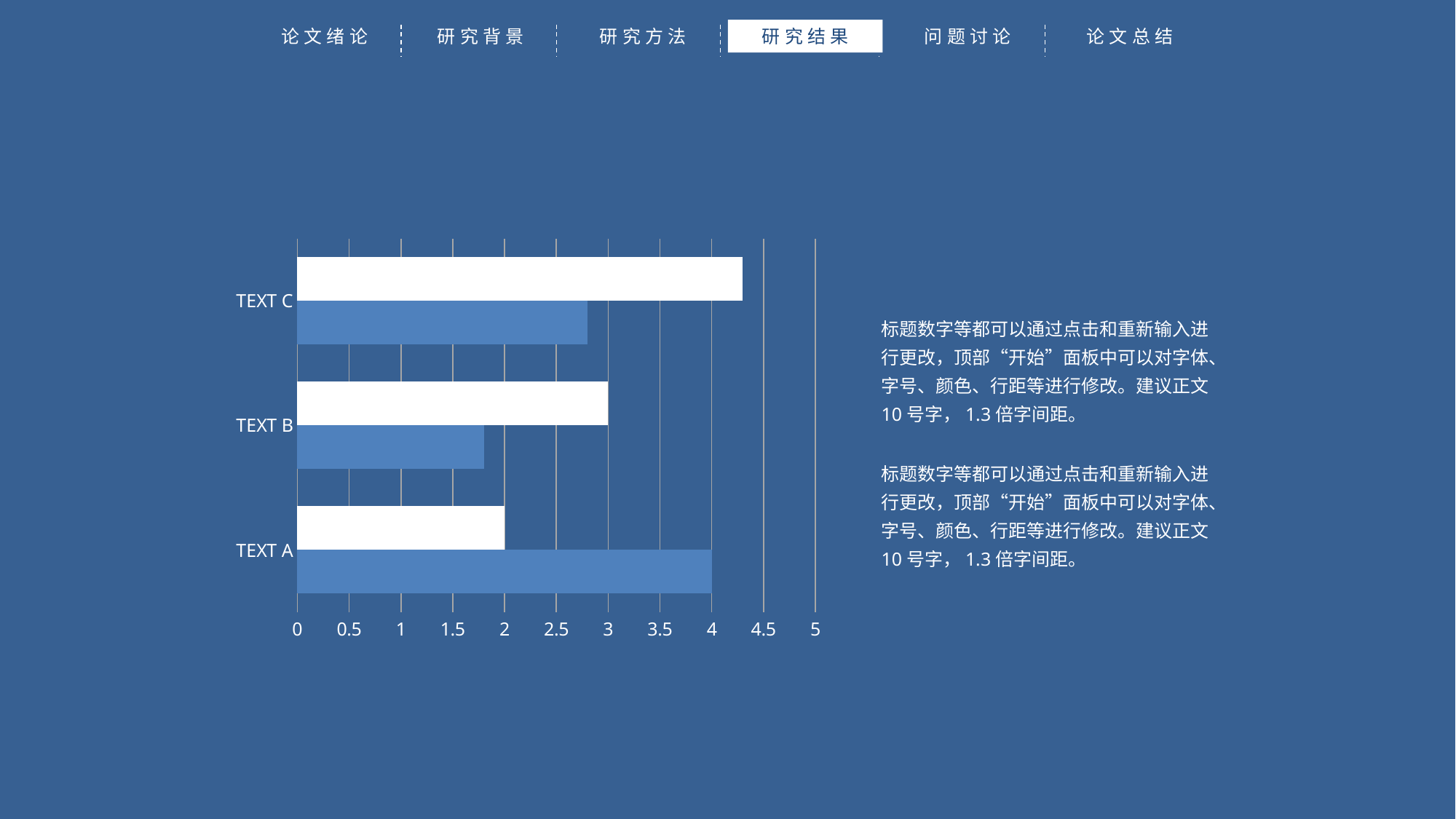
What is the value of the white bar for TEXT B? 3 What is the value of the blue bar for TEXT A? 4 Is the value of the blue bar for TEXT B greater or less than 2? less What is the difference between the blue bar and the white bar for TEXT A? 2 For TEXT A, which bar is longer, the white bar or the blue bar? the blue bar How many categories are shown on the chart? 3 What is the value of the white bar for TEXT A? 2 Which category has the longest white bar? TEXT C Is the value of the blue bar for TEXT C greater or less than 3? less What kind of chart is shown on the slide? bar chart Which category has the shortest blue bar? TEXT B Is the value of the white bar for TEXT C greater or less than 4? greater